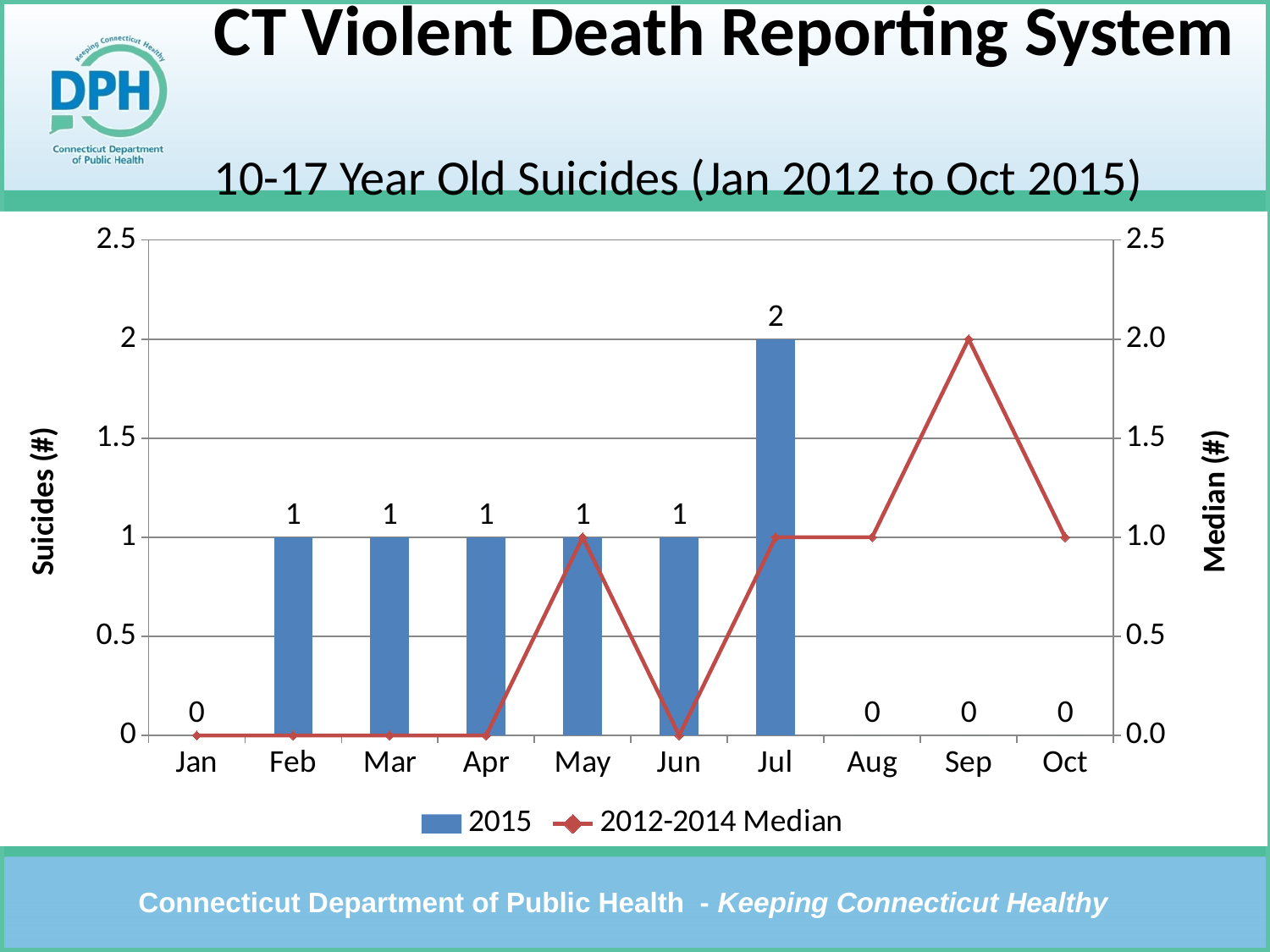
How many series does the legend list? 2 Which month has the highest 2015 value? Jul What is the 2015 value for Jul? 2 How many months are shown on the x axis? 10 Is the 2012-2014 Median value for Sep greater or less than 1.5? greater What is the 2015 value for Feb? 1 What is the difference between the 2015 value for Jul and the 2015 value for Jun? 1 Which is larger in Jul: the 2015 value or the 2012-2014 Median value? 2015 In which month does the 2012-2014 Median line reach its highest point? Sep What kind of chart is used for the 2015 series? bar chart What is the 2015 value for Sep? 0 What is the title of the chart? 10-17 Year Old Suicides (Jan 2012 to Oct 2015)